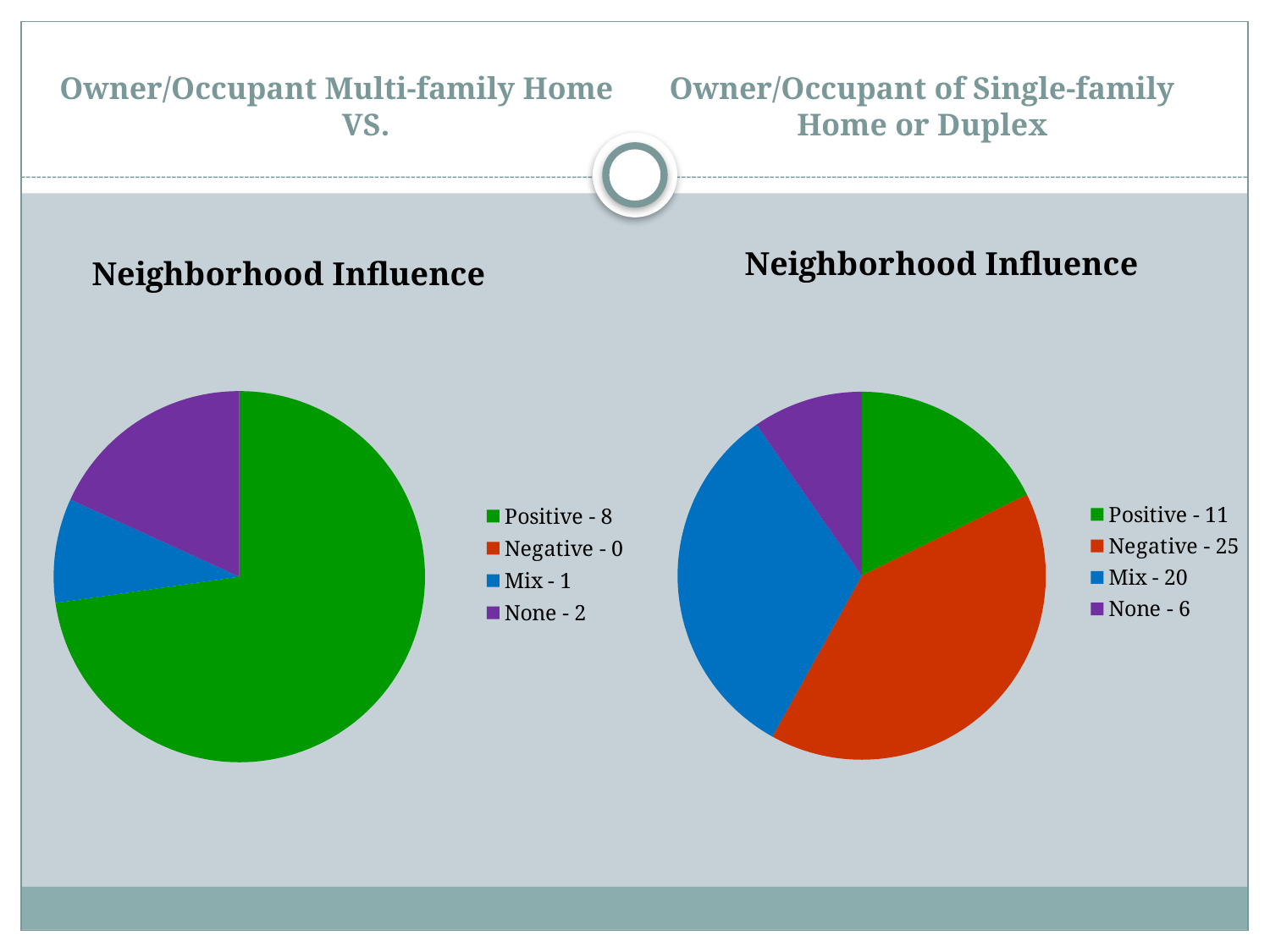
On the right pie chart, what is the difference between Negative and Positive? 14 On the left pie chart, which category has the largest value? Positive What is the title of the left chart? Neighborhood Influence What type of chart is used on the right side of the slide? Pie chart On the right pie chart, which category has the smallest value? None How many categories does the legend of the left pie chart list? 4 On the right pie chart, which is larger, Mix or Positive? Mix On the left pie chart (Owner/Occupant Multi-family Home), what value is shown for Positive? 8 On the right pie chart (Owner/Occupant of Single-family Home or Duplex), what value is shown for Negative? 25 On the left pie chart, which category has the smallest value? Negative What is the total of all values shown in the legend of the right pie chart? 62 On the right pie chart, what value is shown for Mix? 20